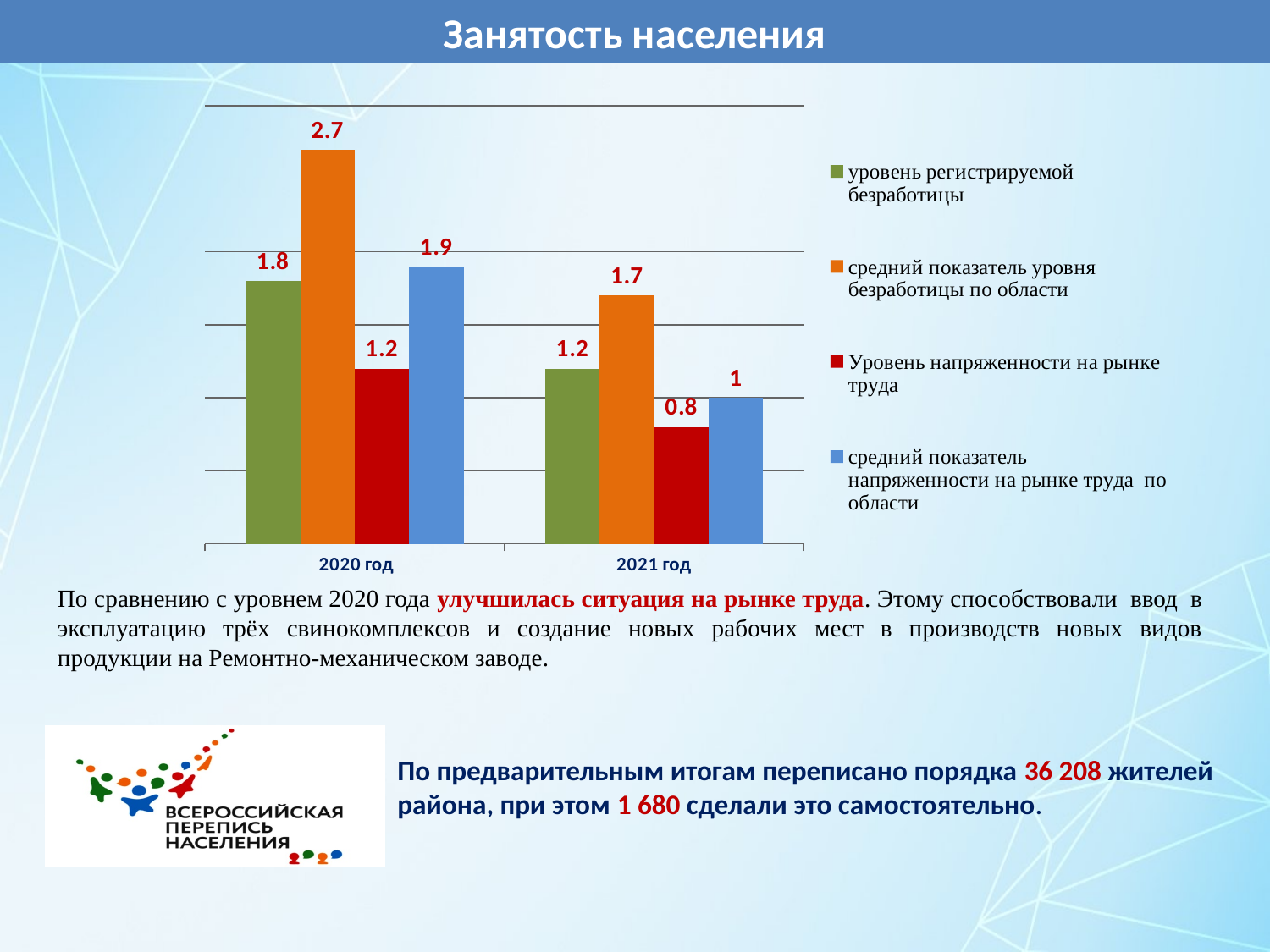
What is the value of 'средний показатель напряженности на рынке труда по области' for 2020 год? 1.9 What is the value of 'уровень регистрируемой безработицы' for 2020 год? 1.8 Does the value of 'Уровень напряженности на рынке труда' rise or fall from 2020 год to 2021 год? fall Which series has the lowest value in 2021 год? Уровень напряженности на рынке труда What is the difference between 'средний показатель уровня безработицы по области' in 2020 год and in 2021 год? 1 How many categories are shown on the x axis? 2 What kind of chart is shown on the slide? bar chart How many series does the legend list? 4 Which is larger: 'уровень регистрируемой безработицы' in 2020 год or in 2021 год? 2020 год Which series has the highest value in 2020 год? средний показатель уровня безработицы по области What is the value of 'средний показатель уровня безработицы по области' for 2021 год? 1.7 What is the value of 'Уровень напряженности на рынке труда' for 2021 год? 0.8